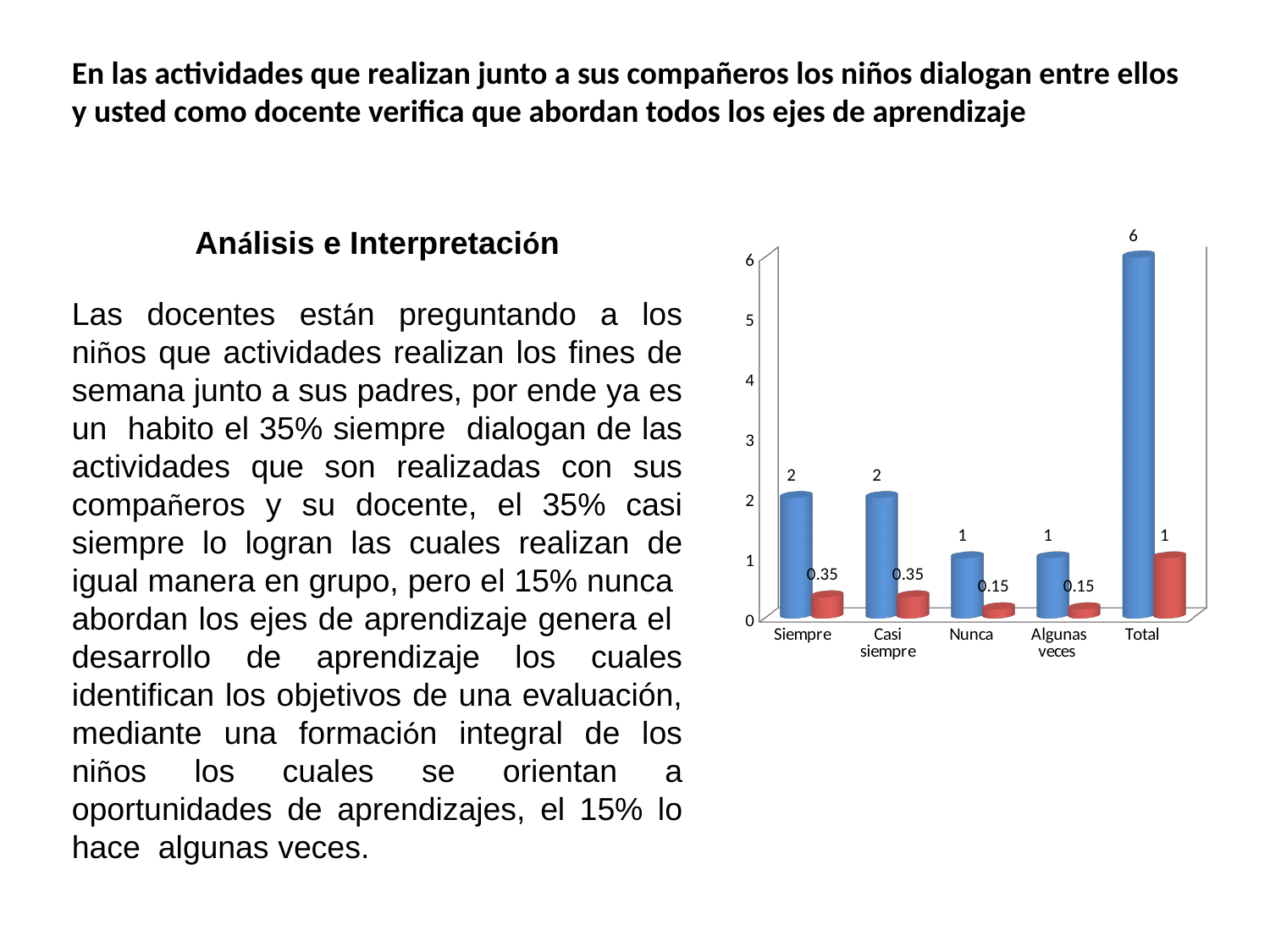
What type of chart is shown on the slide? bar chart What is the value of the red bar for Algunas veces? 0.15 What is the value of the red bar for Casi siempre? 0.35 What is the difference between the red bar for Casi siempre and the red bar for Nunca? 0.2 What is the value of the blue bar for Total? 6 Which category has the highest blue bar? Total What is the value of the blue bar for Nunca? 1 What is the value of the blue bar for Siempre? 2 What is the difference between the blue bar for Total and the blue bar for Siempre? 4 Is the value of the blue bar for Total greater or less than 5? greater How many categories are shown on the x axis of the chart? 5 Which is larger, the red bar for Siempre or the red bar for Nunca? Siempre